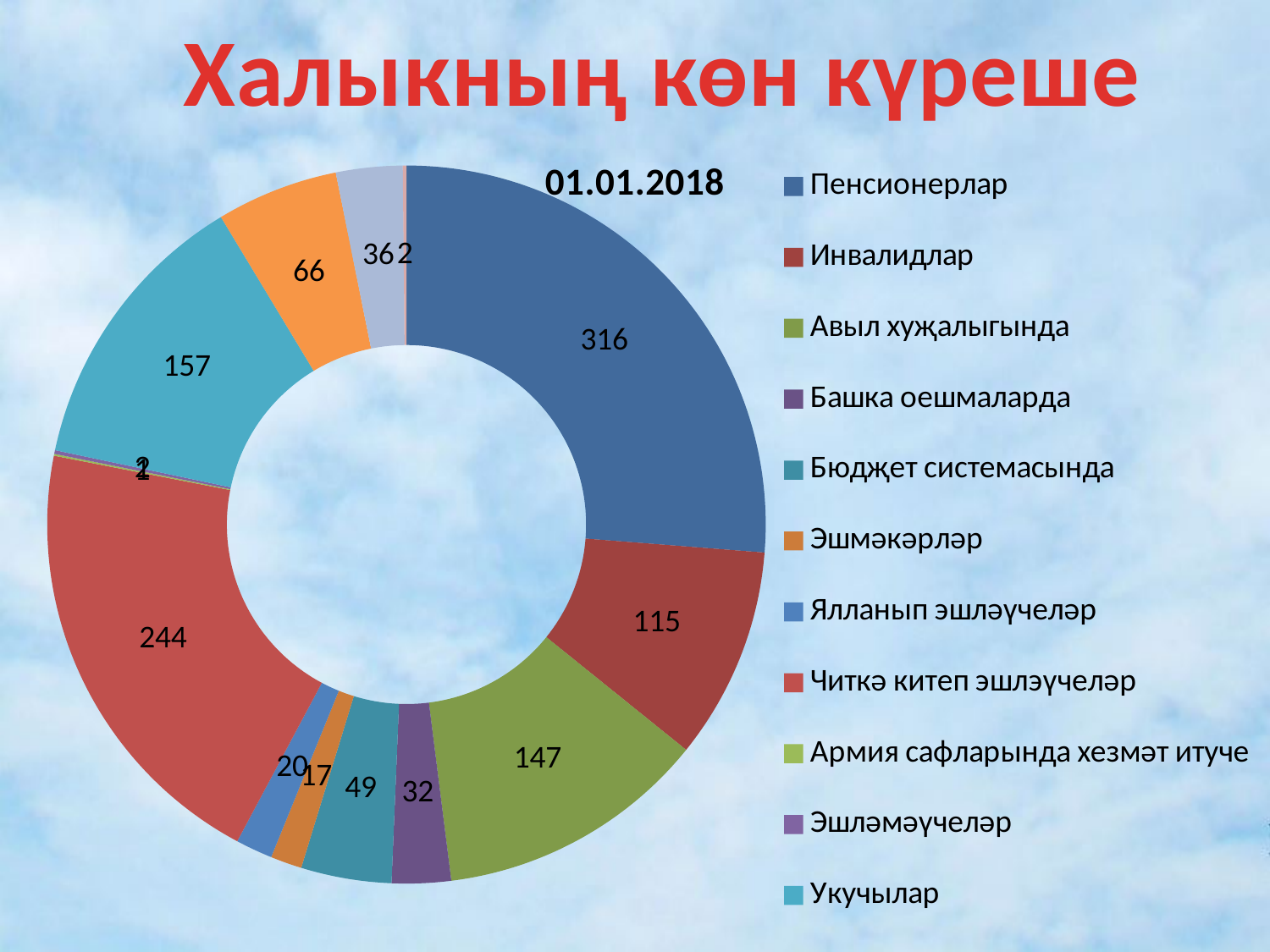
Which is larger, the value for Укучылар or the value for Авыл хуҗалыгында? Укучылар What value is shown for Пенсионерлар? 316 What value is shown for Укучылар? 157 What kind of chart is shown on the slide? Doughnut (pie) chart What is the title of the chart? 01.01.2018 What value is shown for Бюджет системасында? 49 What value is shown for Инвалидлар? 115 What value is shown for Авыл хуҗалыгында? 147 What value is shown for Башка оешмаларда? 32 Which category has the largest slice? Пенсионерлар What is the difference between the values for Пенсионерлар and Читкә китеп эшләүчеләр? 72 What value is shown for Читкә китеп эшләүчеләр? 244